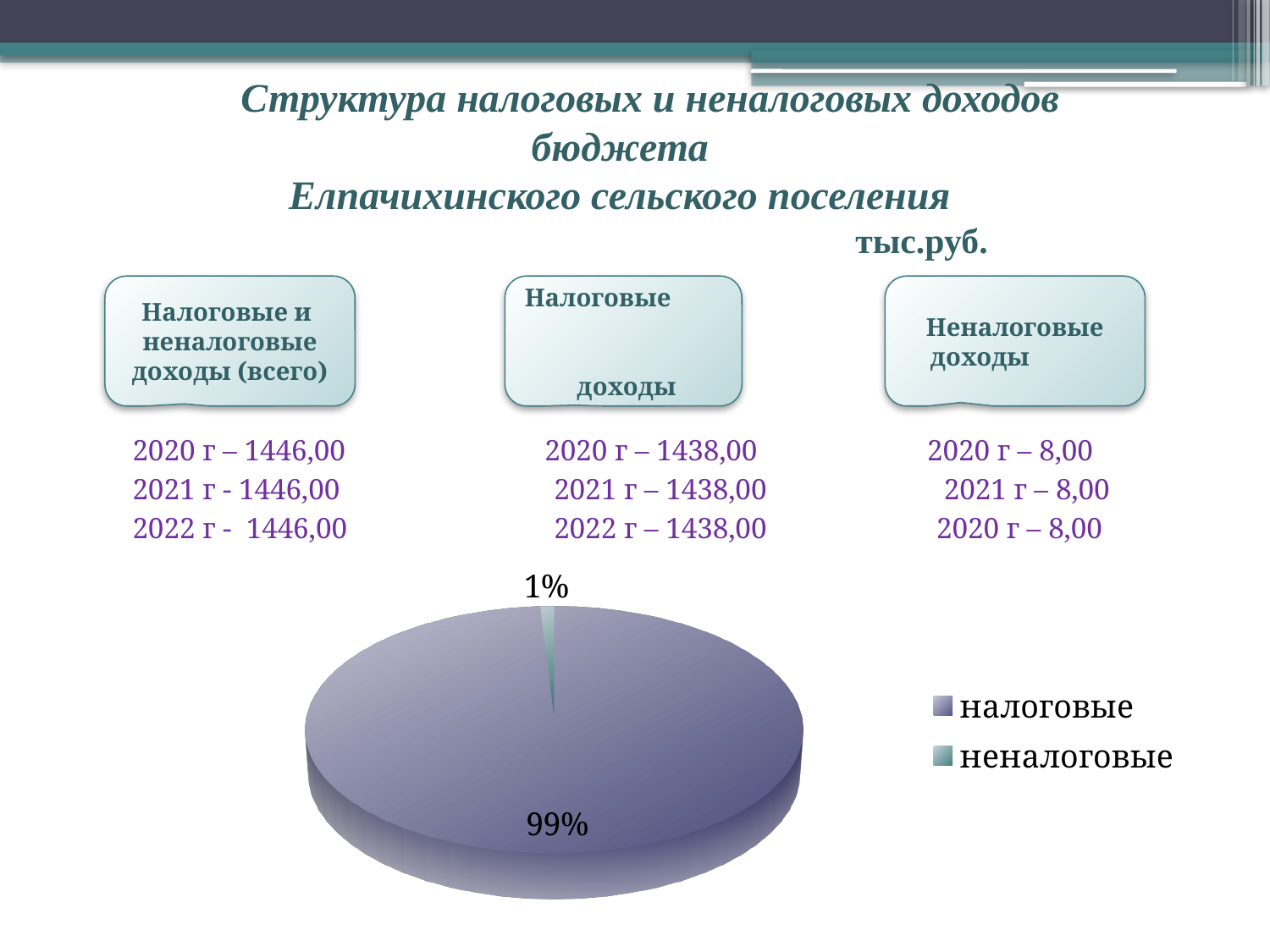
Which is larger in the pie chart, the share for "налоговые" or the share for "неналоговые"? налоговые What kind of chart is shown on the slide? pie chart What share of the pie does the "налоговые" slice represent? 99% How many entries does the legend of the pie chart list? 2 Which slice of the pie chart is the smallest? неналоговые What is the difference in percentage points between the "налоговые" and "неналоговые" slices? 98 What are the two legend entries of the pie chart? налоговые, неналоговые Which legend entry is shown in the purple-blue colour in the pie chart? налоговые What share of the pie does the "неналоговые" slice represent? 1% How many slices does the pie chart have? 2 Which slice of the pie chart is the largest? налоговые